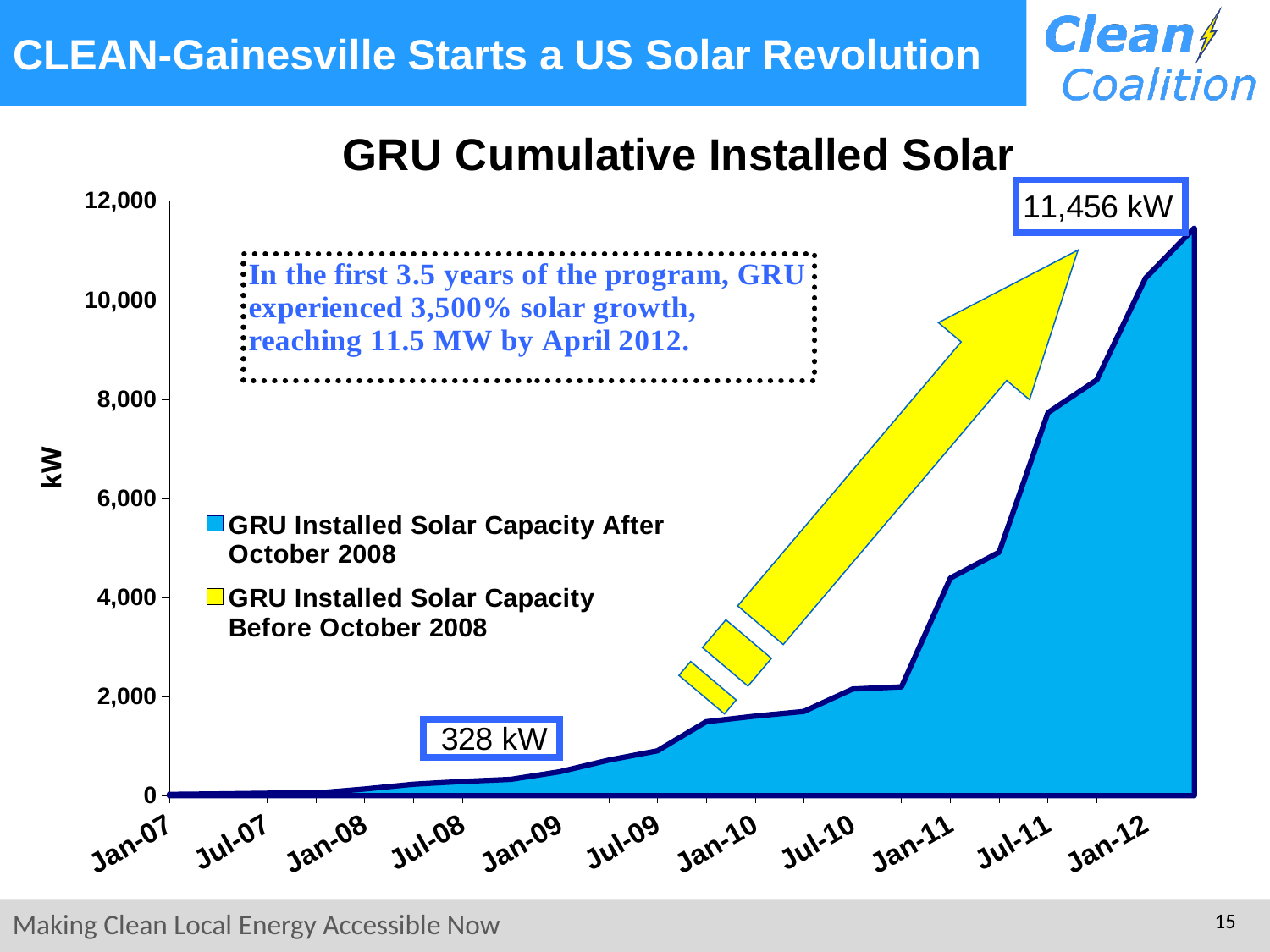
What kind of chart is shown on the slide? Area chart How many date labels are shown on the x axis? 11 Is the value at Jul-11 greater or less than 6,000? greater Is the value at Jan-10 greater or less than 2,000? less What unit is shown on the y axis label? kW How many series does the chart's legend list? 2 Which is larger, the value at Jul-11 or the value at Jan-10? Jul-11 Do the values rise or fall along the x axis from Jan-07 to Jan-12? Rise What is the lower value labeled on the chart, near Jul-08? 328 kW What is the highest value labeled on the chart, at the end of the series? 11,456 kW What is the difference between the two labeled values, 11,456 kW and 328 kW? 11,128 kW What is the title of the chart? GRU Cumulative Installed Solar